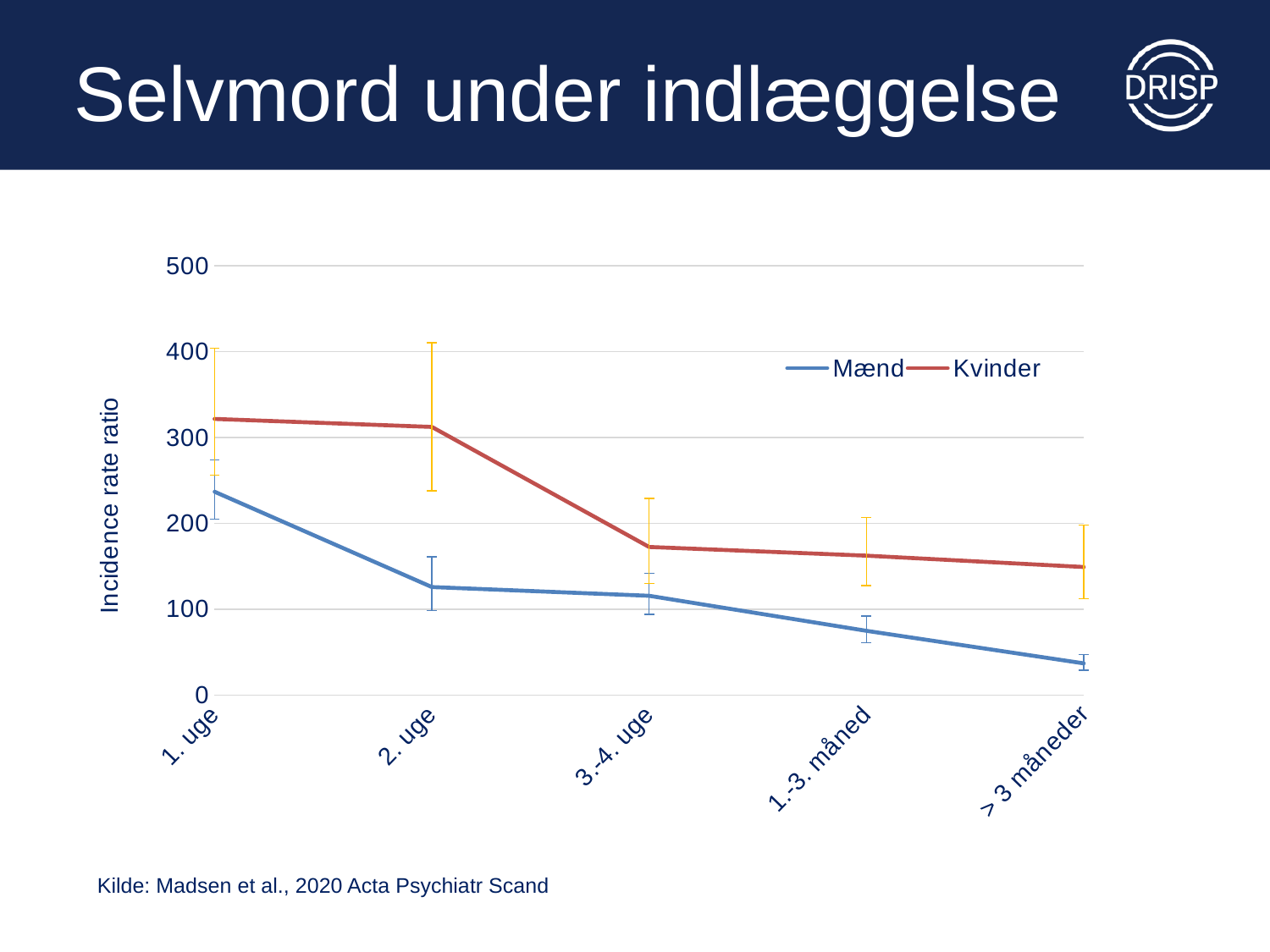
Is the value for Kvinder at 1. uge greater or less than 300? greater How many categories are shown on the x axis? 5 Is the value for Mænd at 2. uge greater or less than 200? less Is the value for Mænd at > 3 måneder greater or less than 100? less At which category is the value for Mænd lowest? > 3 måneder How many series does the legend list? 2 Do the values for Mænd rise or fall from 1. uge to > 3 måneder? fall Which series has the higher value at 3.-4. uge, Mænd or Kvinder? Kvinder What is the label of the y axis? Incidence rate ratio Which series has the higher value at 1. uge, Mænd or Kvinder? Kvinder What kind of chart is shown on the slide? line chart Do the values for Kvinder rise or fall along the x axis? fall